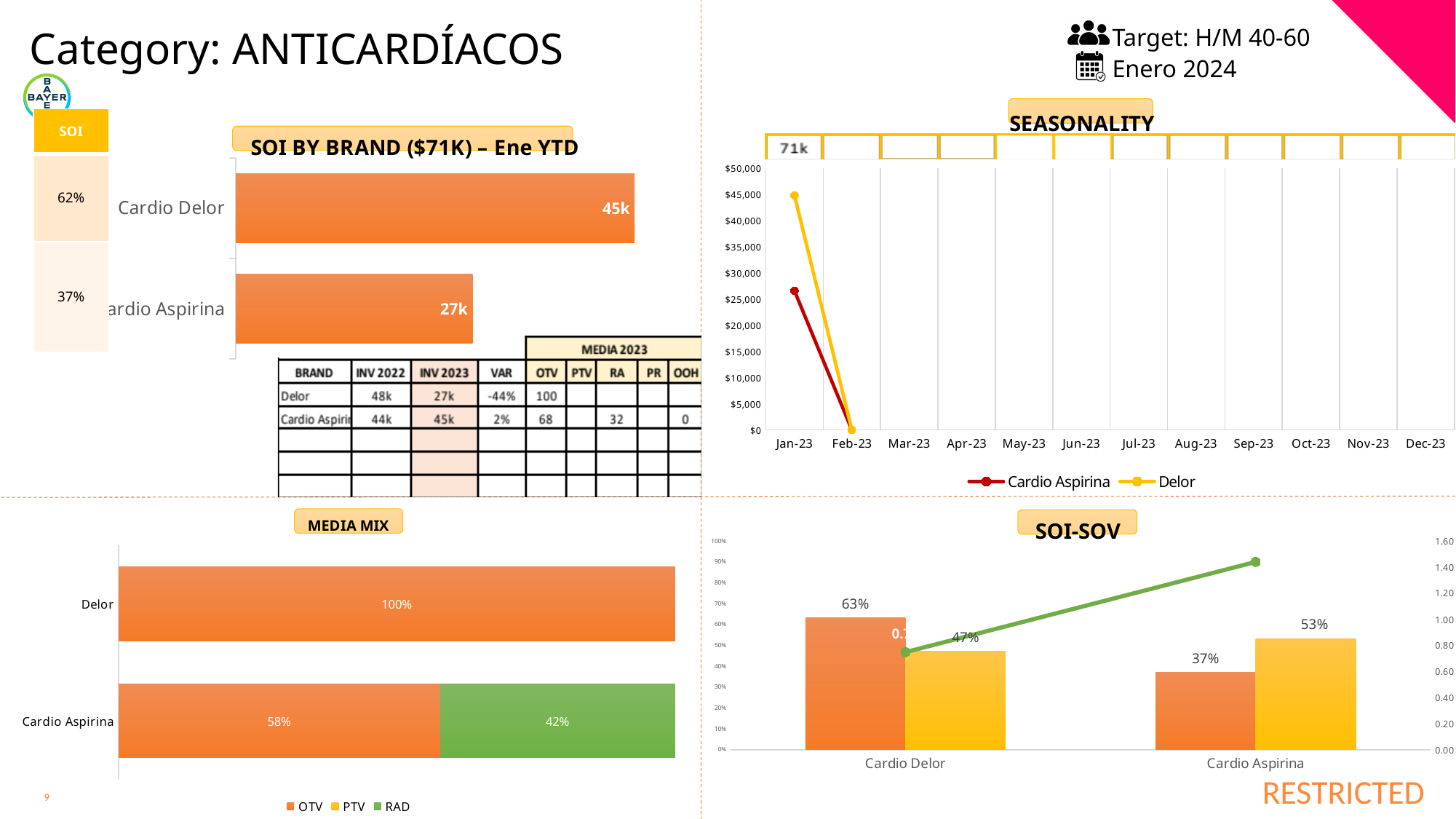
In the SOI BY BRAND chart, what is the value for Cardio Delor? 45k In the SOI-SOV chart, which is larger: the orange bar for Cardio Delor or the orange bar for Cardio Aspirina? Cardio Delor In the SOI BY BRAND chart, which brand has the highest value? Cardio Delor In the MEDIA MIX chart, how many series does the legend list? 3 In the SEASONALITY chart, is the Delor value for Jan-23 greater or less than $40,000? greater In the SOI BY BRAND chart, what is the value for Cardio Aspirina? 27k In the MEDIA MIX chart, what is the OTV share for Cardio Aspirina? 58% In the SEASONALITY chart, how many series does the legend list? 2 In the MEDIA MIX chart, what is the RAD share for Cardio Aspirina? 42% In the SEASONALITY chart, do the values for Delor rise or fall from Jan-23 to Feb-23? fall What kind of chart is the SOI BY BRAND chart? Bar chart In the SOI BY BRAND chart, what is the difference between Cardio Delor and Cardio Aspirina? 18k